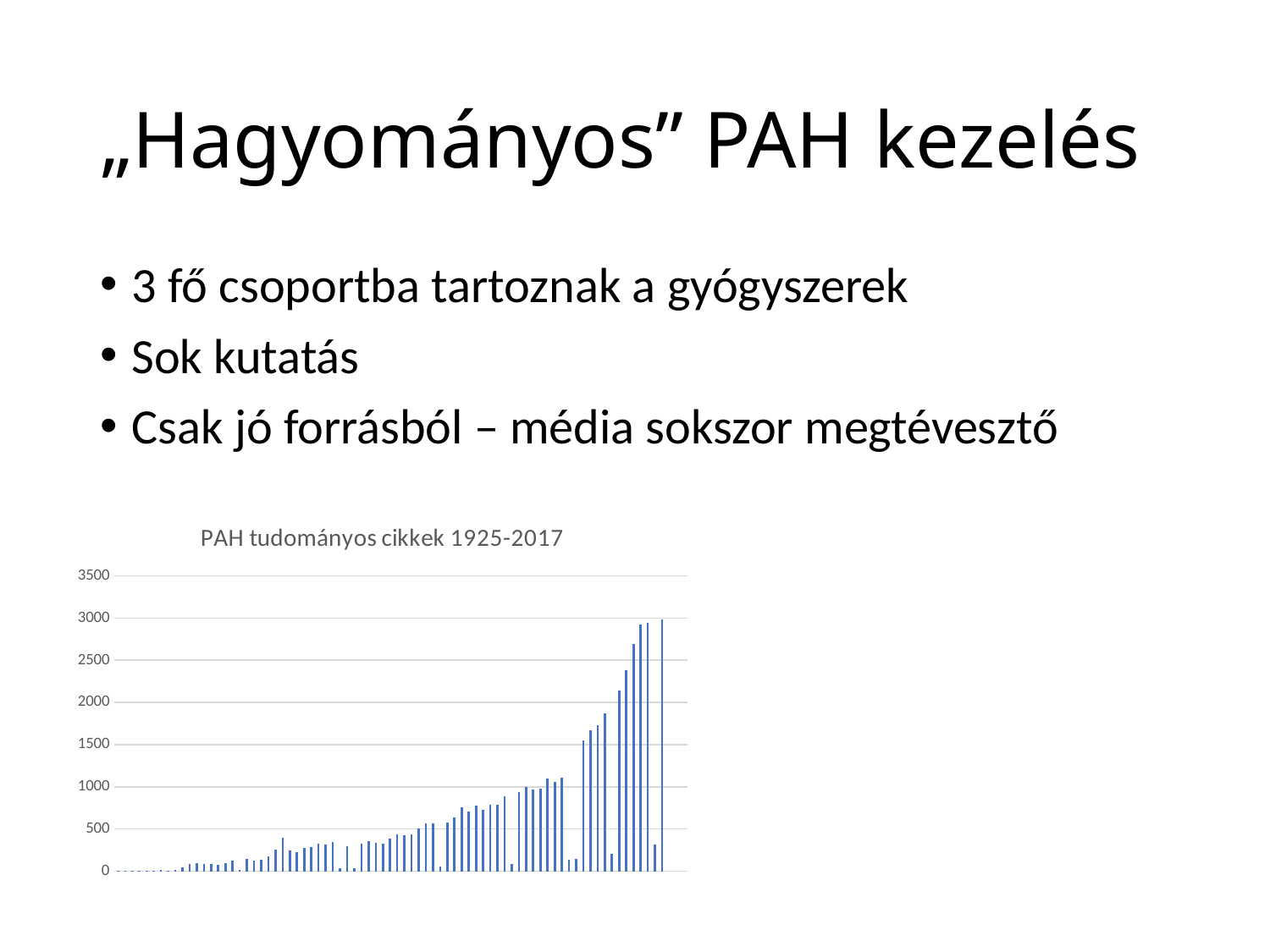
Is the value of the tallest bar in the chart greater or less than 2500? greater What is the highest tick value shown on the y axis of the chart? 3500 Do the values in the chart generally rise or fall from left to right along the x axis? rise Is the value of the first (leftmost) bar in the chart greater or less than 500? less What kind of chart is shown on the slide? bar chart Is the value of the tallest bar in the chart greater or less than 3500? less What is the title of the chart on the slide? PAH tudományos cikkek 1925-2017